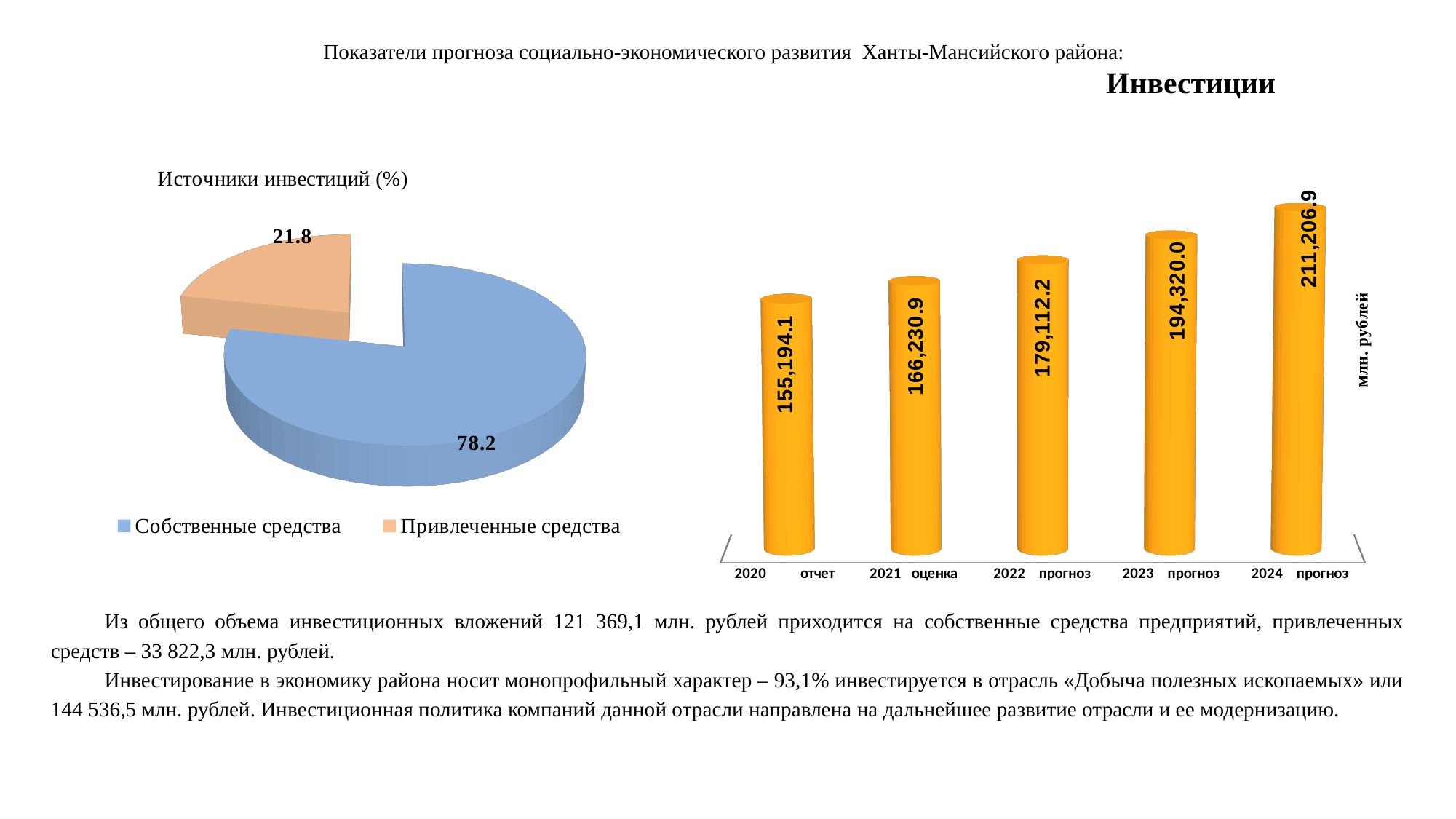
In the bar chart on the right, what is the value for 2020 отчет? 155,194.1 In the bar chart on the right, what is the difference between the values for 2024 прогноз and 2020 отчет? 56,012.8 In the bar chart on the right, what is the value for 2023 прогноз? 194,320.0 In the pie chart 'Источники инвестиций (%)', how many entries does the legend list? 2 In the pie chart 'Источники инвестиций (%)', what is the share for Привлеченные средства? 21.8 In the bar chart on the right, which year has the highest value? 2024 прогноз In the bar chart on the right, which year has the lowest value? 2020 отчет In the bar chart on the right, how many bars are plotted? 5 In the pie chart 'Источники инвестиций (%)', what is the share for Собственные средства? 78.2 In the pie chart 'Источники инвестиций (%)', which category has the larger slice? Собственные средства In the bar chart on the right, do the values rise or fall from 2020 to 2024? Rise What kind of chart is the chart on the left of the slide? Pie chart